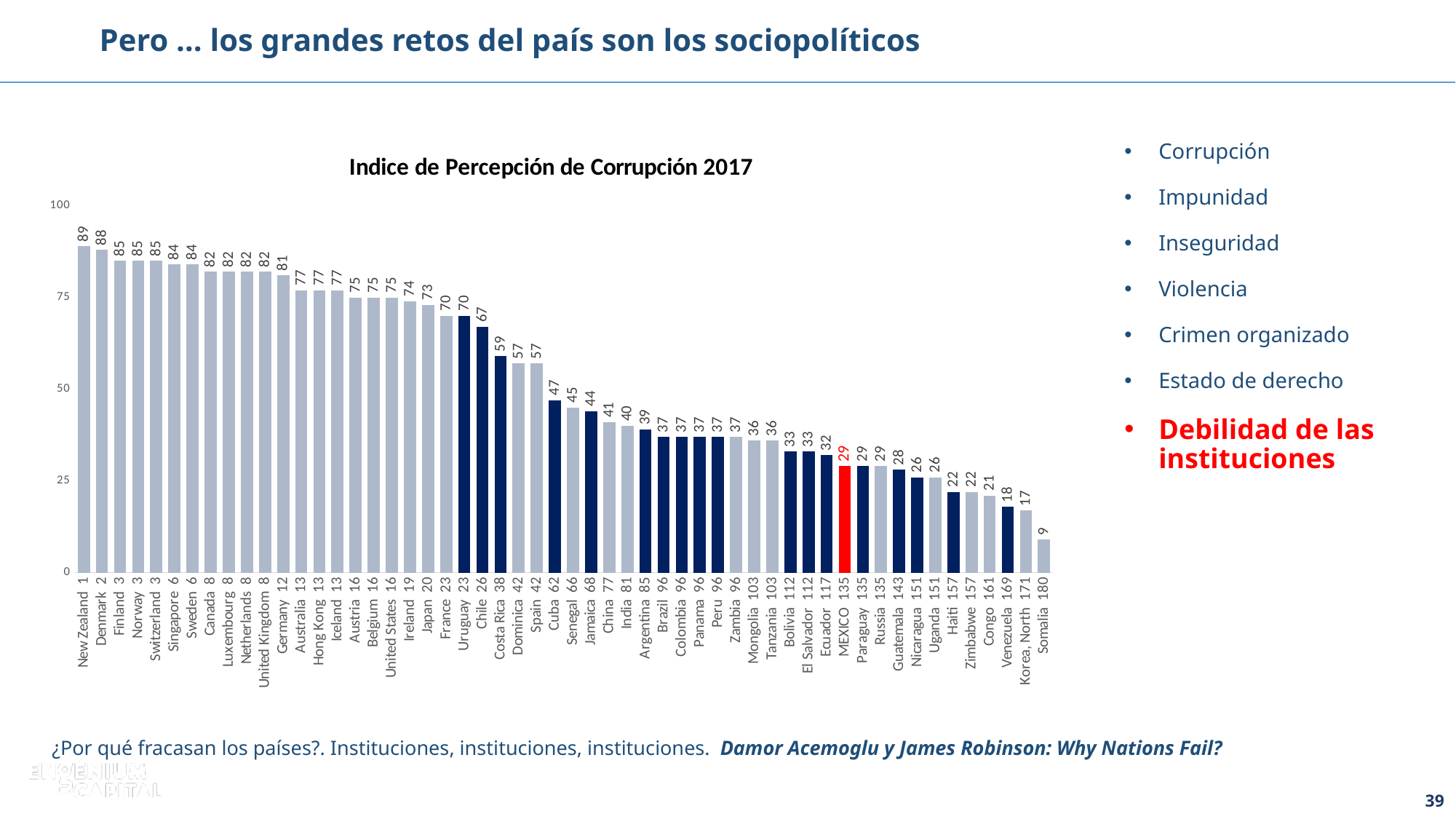
Which country has the lowest value in the chart? Somalia Which country's bar is coloured red in the chart? MEXICO What is the value shown for MEXICO in the Indice de Percepción de Corrupción 2017 chart? 29 Do the values rise or fall moving from left to right along the x axis? fall What kind of chart is shown on the slide? bar chart What is the difference between the values for New Zealand and Somalia? 80 What is the value shown for Somalia in the chart? 9 Which has a larger value, Uruguay or Costa Rica? Uruguay Is the value for Venezuela greater or less than 25? less Which country has the highest value in the chart? New Zealand What is the value shown for Chile in the chart? 67 What is the difference between the values for Chile and MEXICO? 38